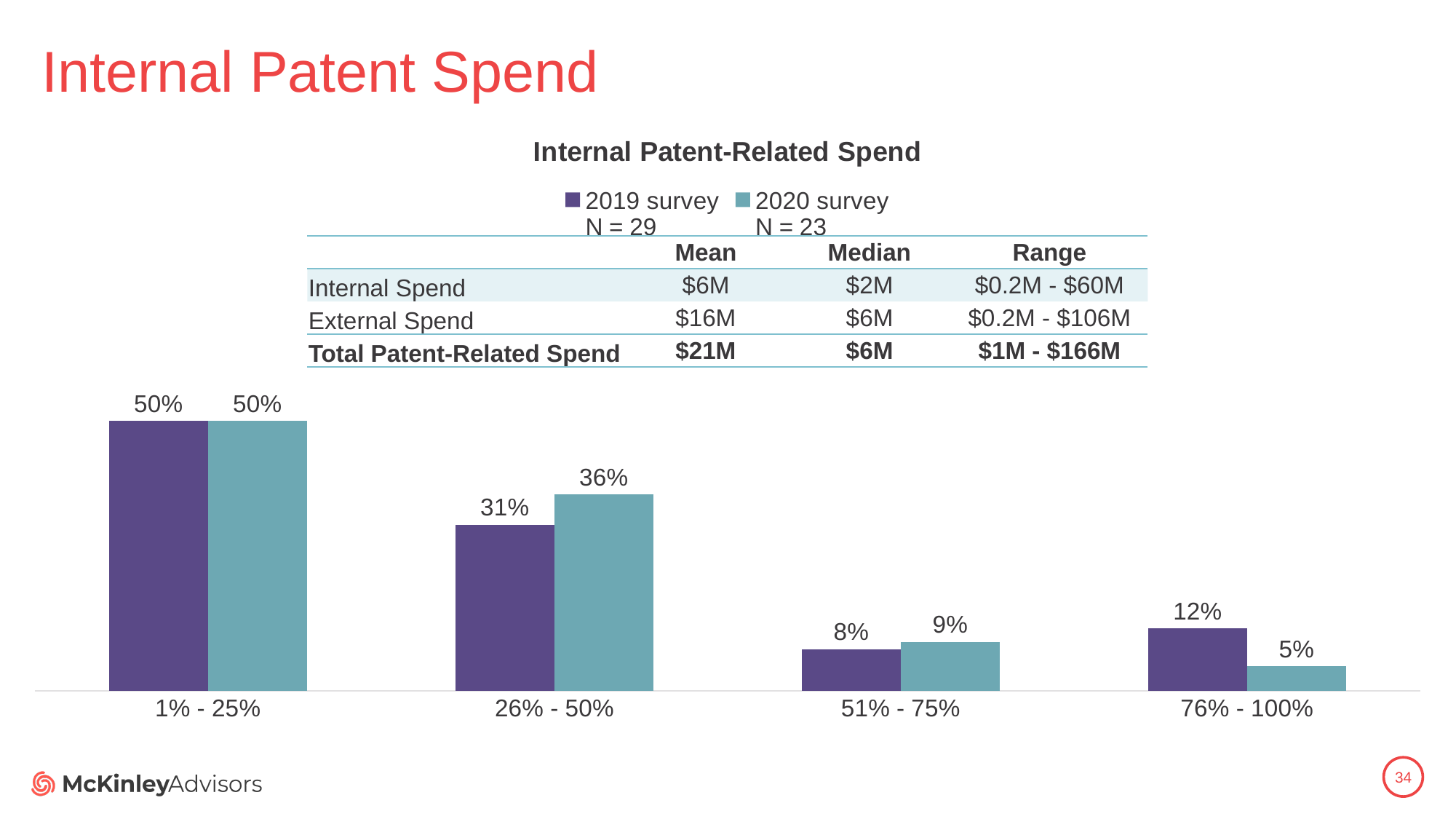
What is the 2020 survey value for the 51% - 75% category? 9% What is the title of the chart? Internal Patent-Related Spend What is the 2020 survey value for the 76% - 100% category? 5% For the 76% - 100% category, which series has the larger value, 2019 survey or 2020 survey? 2019 survey What kind of chart is shown on the slide? bar chart How many series does the chart legend list? 2 Which category has the lowest value in the 2019 survey series? 51% - 75% What is the 2019 survey value for the 26% - 50% category? 31% How many categories are shown on the x axis of the chart? 4 What is the difference between the 2020 survey and 2019 survey values for the 26% - 50% category? 5% Which category has the highest value in the 2020 survey series? 1% - 25% Do the 2019 survey values rise or fall from the 1% - 25% category to the 51% - 75% category? fall